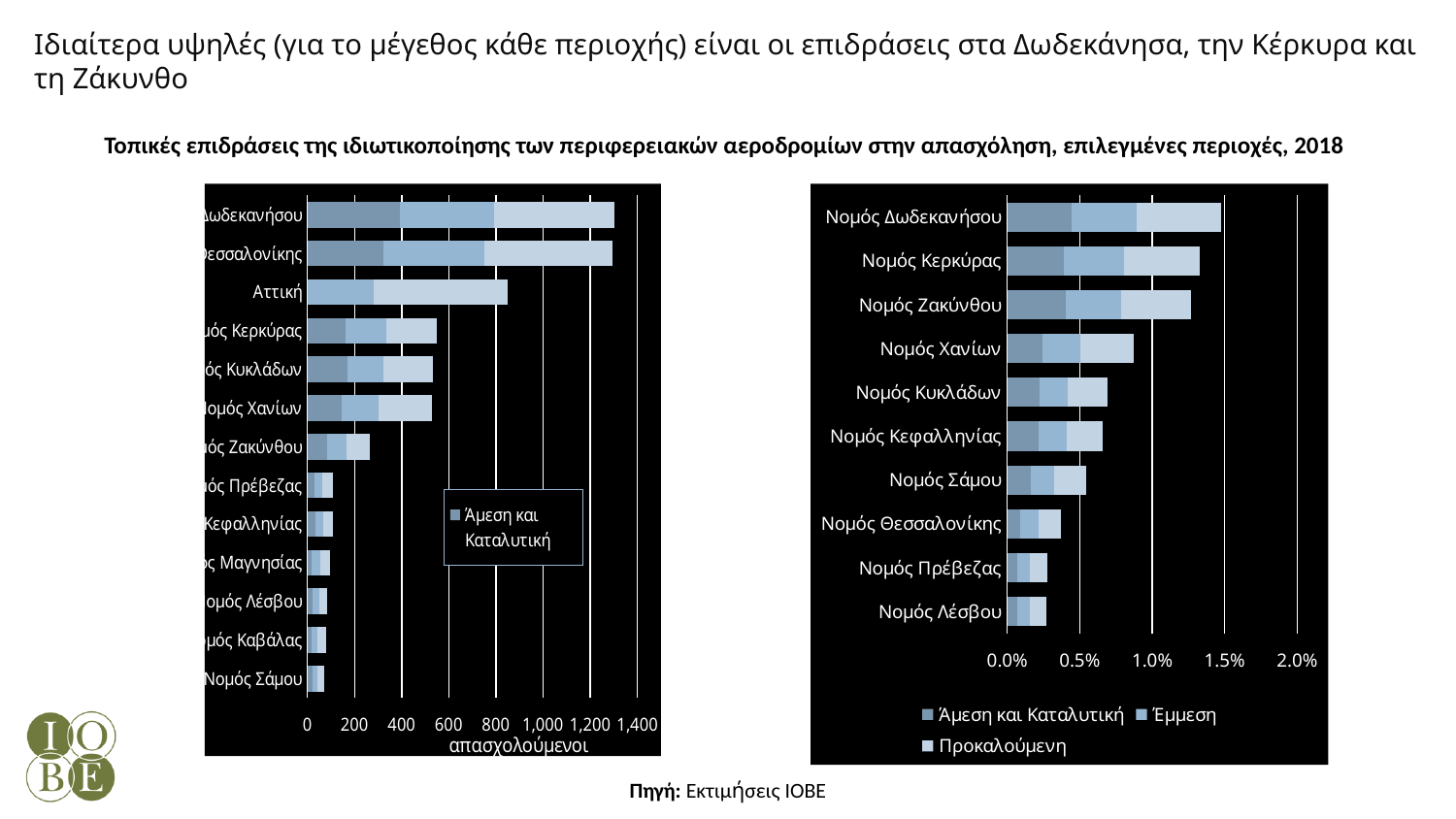
What kind of chart is the left chart? bar chart In the left chart, is the total value for Ζακύνθου greater or less than 400? less In the right chart, is the total value for Νομός Κερκύρας greater or less than 1.0%? greater In the left chart, how many regions are plotted? 13 In the right chart, how many regions are plotted? 10 What is the highest tick label shown on the x axis of the right chart? 2.0% In the left chart, which has the larger total value, Αττική or Κερκύρας? Αττική In the right chart, how many series does the legend list? 3 In the left chart, is the total value for Αττική greater or less than 1,000? less In the right chart, which has the larger total value, Νομός Κυκλάδων or Νομός Θεσσαλονίκης? Νομός Κυκλάδων In the right chart, which region has the highest total value? Νομός Δωδεκανήσου